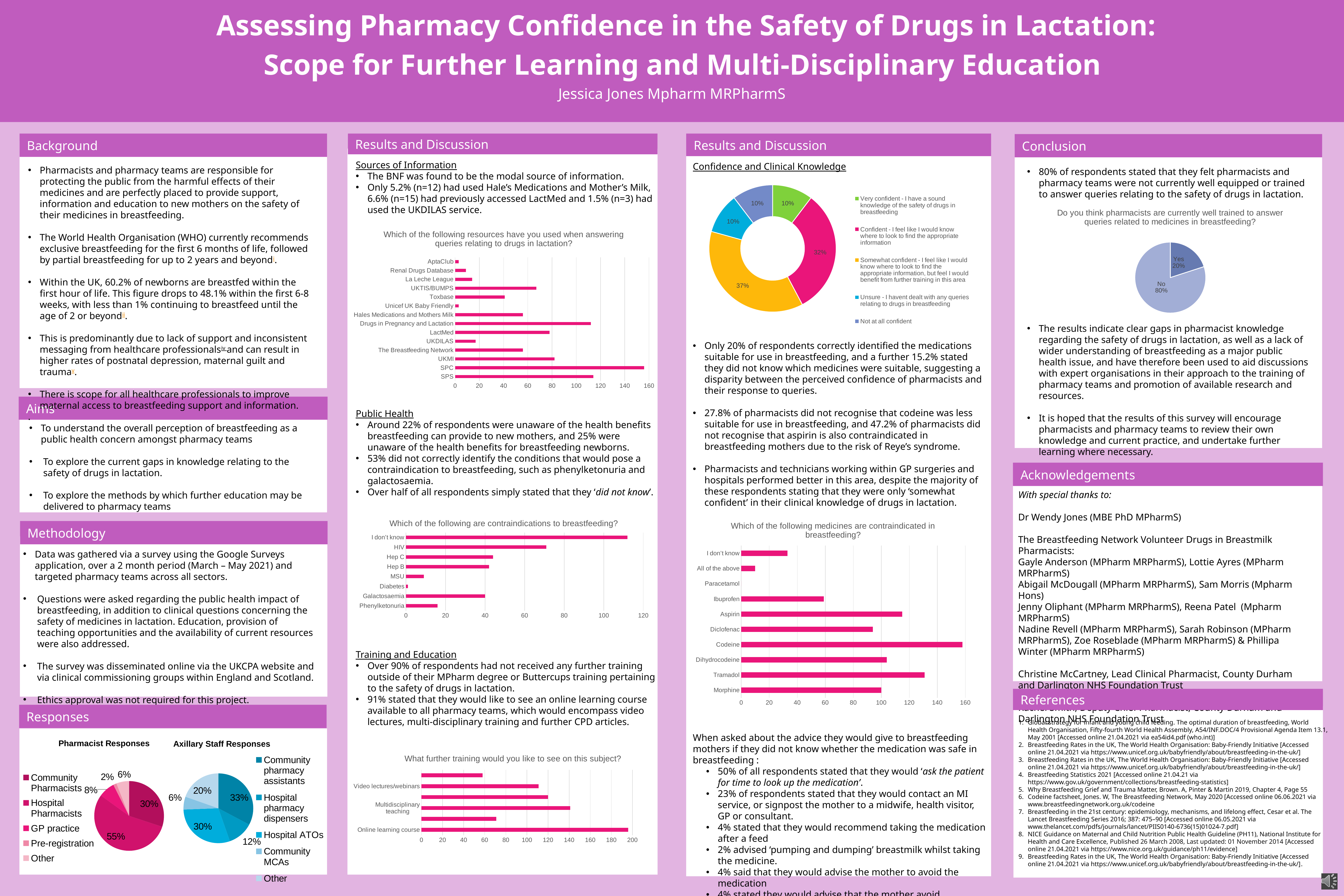
In the Pharmacist Responses pie chart, what percentage were Hospital Pharmacists? 55% In the Axillary Staff Responses pie chart, what percentage were Community pharmacy assistants? 33% In the 'Do you think pharmacists are currently well trained to answer queries related to medicines in breastfeeding?' pie chart, what percentage answered No? 80% In the 'Which of the following medicines are contraindicated in breastfeeding?' chart, which medicine has the highest count? Codeine In the Confidence and Clinical Knowledge donut chart, what share of respondents were 'Confident'? 32% In the 'Which of the following medicines are contraindicated in breastfeeding?' chart, is the value for Aspirin greater or less than 100? greater How many entries does the legend of the Confidence and Clinical Knowledge donut chart list? 5 In the 'Which of the following are contraindications to breastfeeding?' chart, which category has the highest count? I don't know In the Pharmacist Responses pie chart, what is the difference between the Hospital Pharmacists and Community Pharmacists shares? 25% In the 'Which of the following resources have you used when answering queries relating to drugs in lactation?' chart, which resource has the highest count? SPC In the 'Do you think pharmacists are currently well trained' pie chart, what percentage answered Yes? 20% In the Confidence and Clinical Knowledge donut chart, what share of respondents were 'Somewhat confident'? 37%